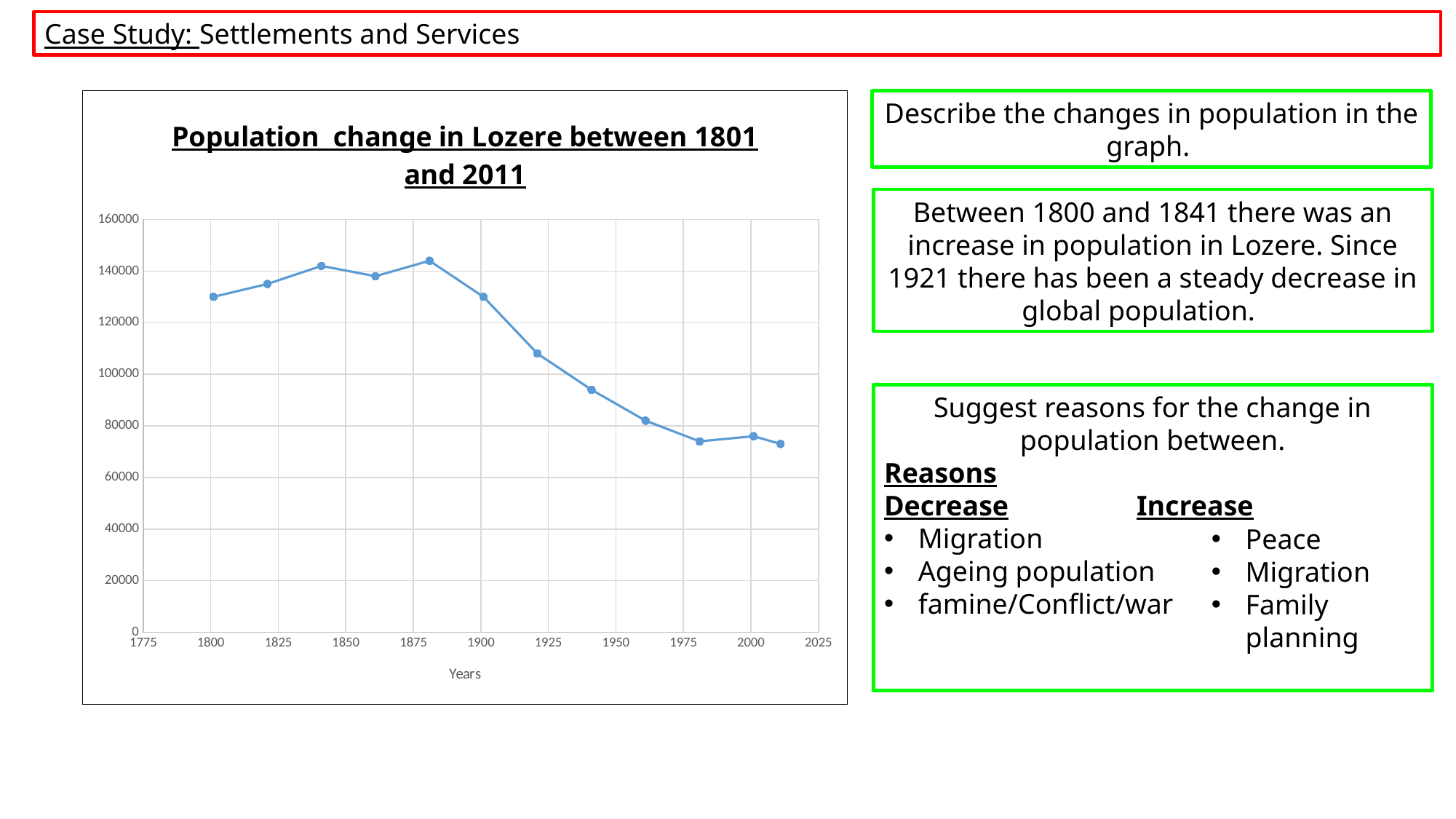
How many data points are plotted on the line? 12 What kind of chart is shown on the slide? line chart Is the population at the first point (1801) greater or less than 120000? greater Is the population at the point around 1981 greater or less than 80000? less Is the population at the last point (2011) greater or less than 80000? less What is the title of the chart? Population change in Lozere between 1801 and 2011 Which is larger, the population at the point around 1901 or at the point around 1921? 1901 Overall, does the population rise or fall between the first point (1801) and the last point (2011)? fall What is the label on the x axis of the chart? Years Which is larger, the population at the first point (1801) or at the last point (2011)? 1801